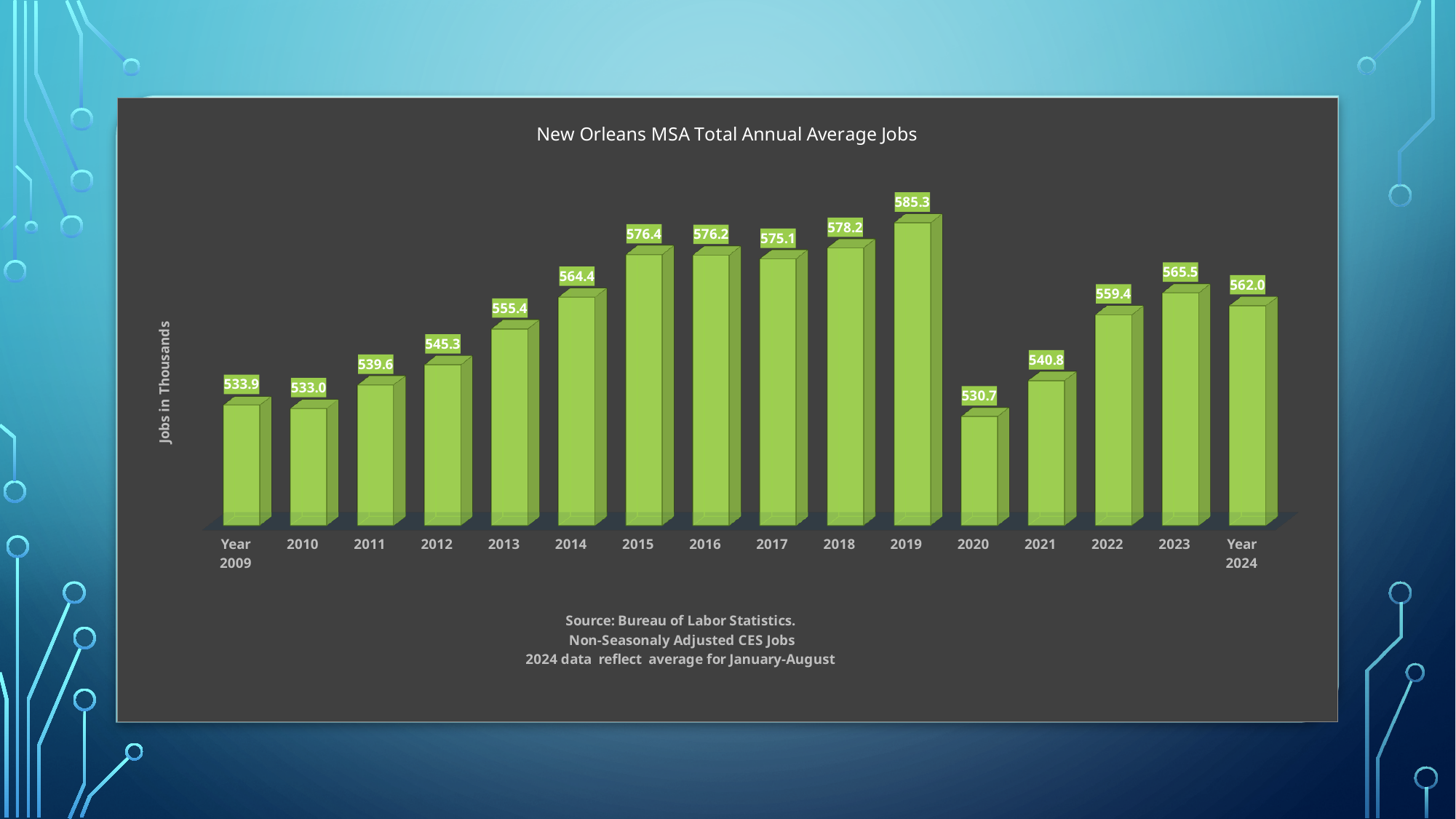
What is the difference between the values for 2023 and 2022? 6.1 Do the values rise or fall from 2009 to 2015? Rise What is the value for 2020? 530.7 Which is larger, the value for 2018 or the value for 2017? 2018 What is the title of the chart? New Orleans MSA Total Annual Average Jobs Which year has the lowest value? 2020 What is the value for 2019? 585.3 What is the value for Year 2024? 562.0 What kind of chart is this? Bar chart What is the difference between the values for 2019 and 2020? 54.6 How many years are shown on the x axis? 16 Which year has the highest value? 2019